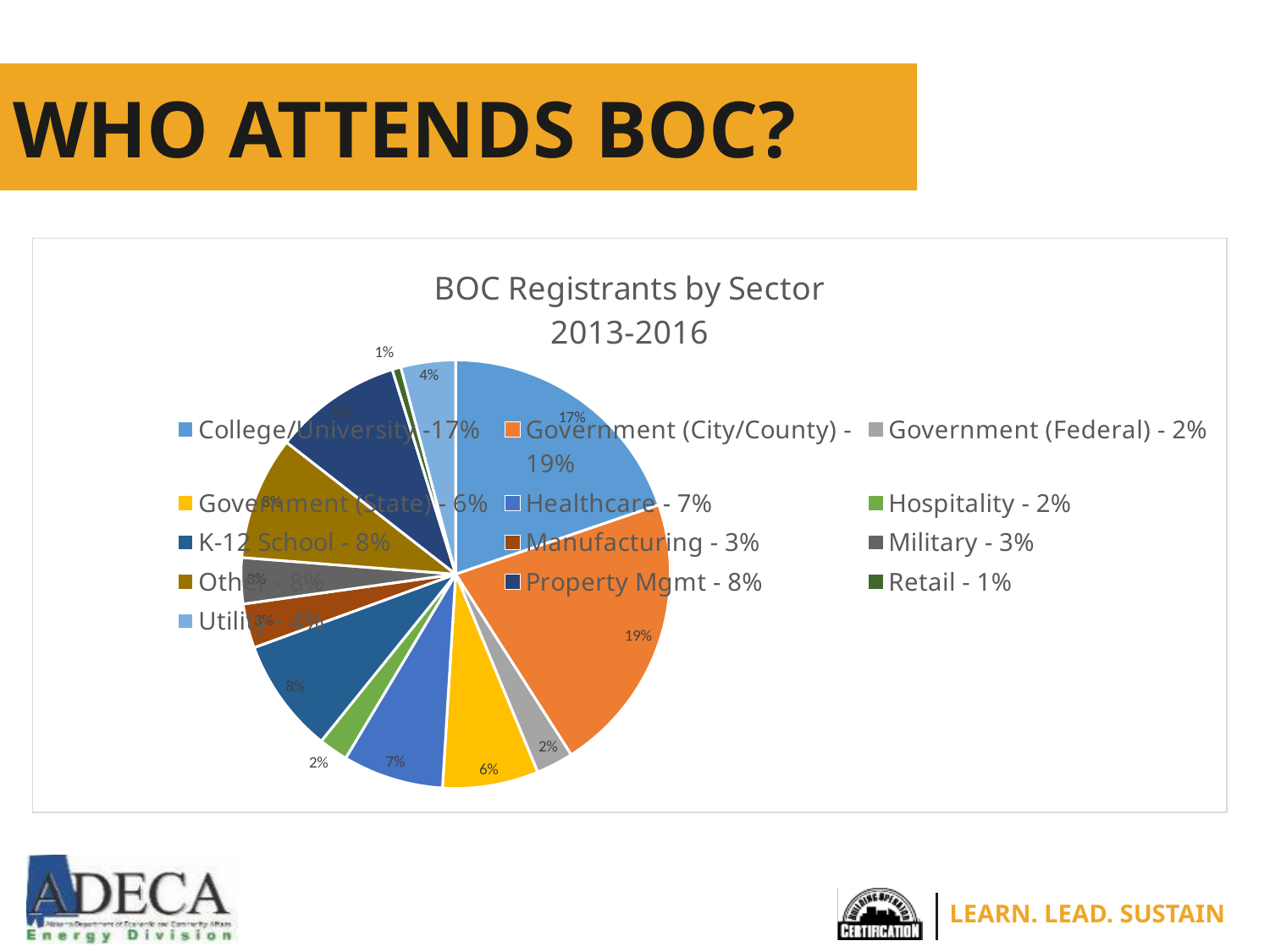
What type of chart is shown on the slide? pie chart What is the title of the chart? BOC Registrants by Sector 2013-2016 What share of BOC registrants is Retail? 1% What share of BOC registrants is Healthcare? 7% What share of BOC registrants is Government (City/County)? 19% What is the difference between the Government (City/County) share and the College/University share? 2% Which sector has the largest share of BOC registrants? Government (City/County) Which sector has the smallest share of BOC registrants? Retail Which is larger, the Healthcare share or the Government (State) share? Healthcare How many sectors does the legend list? 13 What share of BOC registrants is College/University? 17% What share of BOC registrants is Property Mgmt? 8%